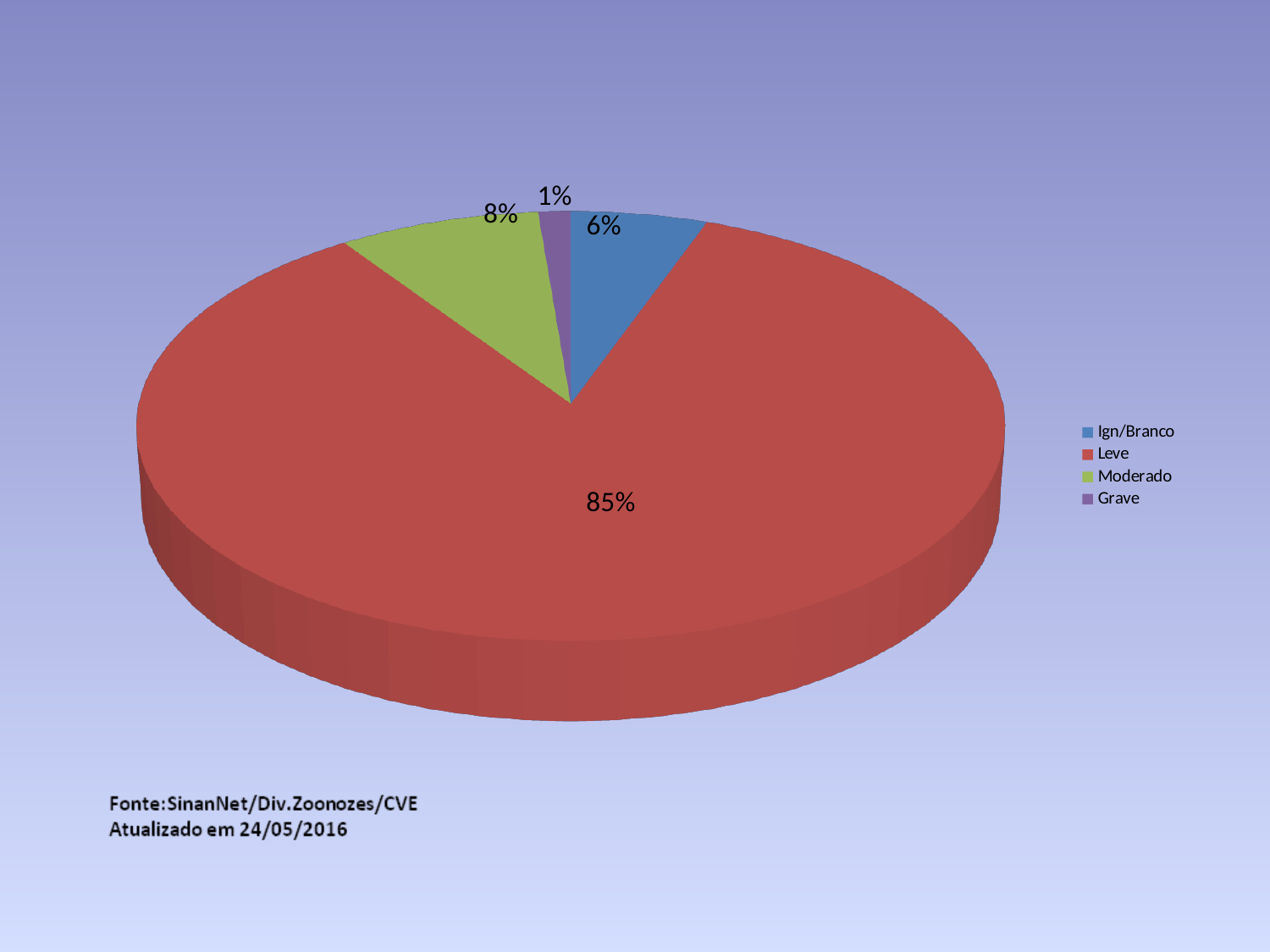
How many categories does the legend list? 4 What share of the pie does Leve have? 85% What share of the pie does Moderado have? 8% Which is larger, the share for Moderado or the share for Ign/Branco? Moderado What colour is the slice for Moderado? green What source is cited below the chart? SinanNet/Div.Zoonozes/CVE Which category has the largest slice of the pie? Leve What is the difference in percentage points between the Leve share and the Moderado share? 77 What share of the pie does Ign/Branco have? 6% Which category has the smallest slice of the pie? Grave What kind of chart is shown on the slide? pie chart